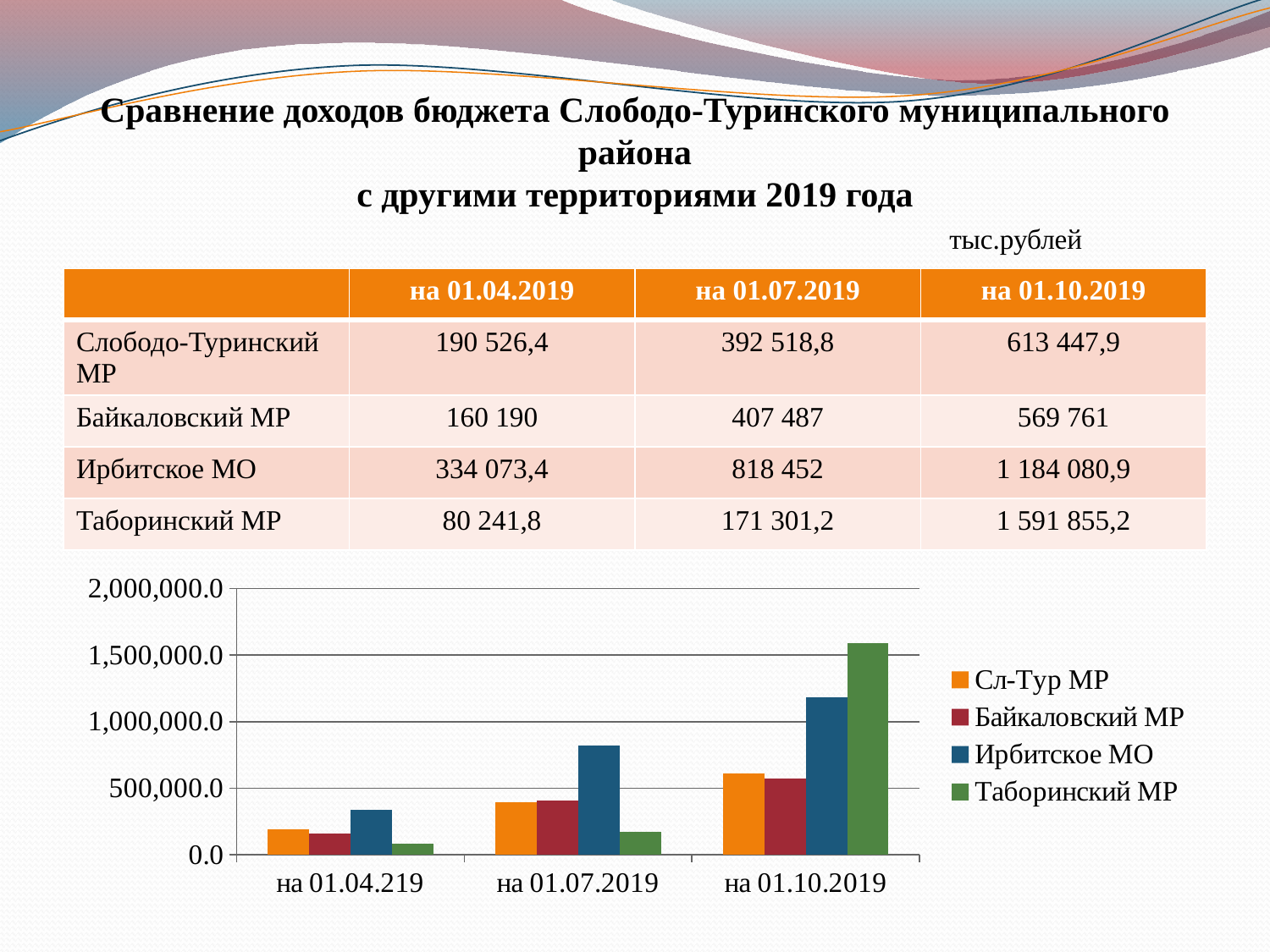
In the chart, which series has the highest bar for на 01.10.2019? Таборинский МР According to the table, what is the value for Ирбитское МО на 01.10.2019? 1 184 080,9 How many categories (dates) are shown along the x axis of the chart? 3 According to the table, what is the difference between Слободо-Туринский МР and Байкаловский МР на 01.10.2019? 43 686,9 What kind of chart is shown on the slide? bar chart In the chart, is the value for Ирбитское МО at на 01.07.2019 greater or less than 1,000,000.0? less In the chart, is the value for Таборинский МР at на 01.10.2019 greater or less than 1,500,000.0? greater In the chart, do the bars for Сл-Тур МР rise or fall from на 01.04.219 to на 01.10.2019? rise In the chart, for на 01.07.2019, which is larger: Ирбитское МО or Сл-Тур МР? Ирбитское МО How many series does the chart's legend list? 4 What colour represents Таборинский МР in the chart's legend? green In the chart, which series has the lowest bar for на 01.04.219? Таборинский МР